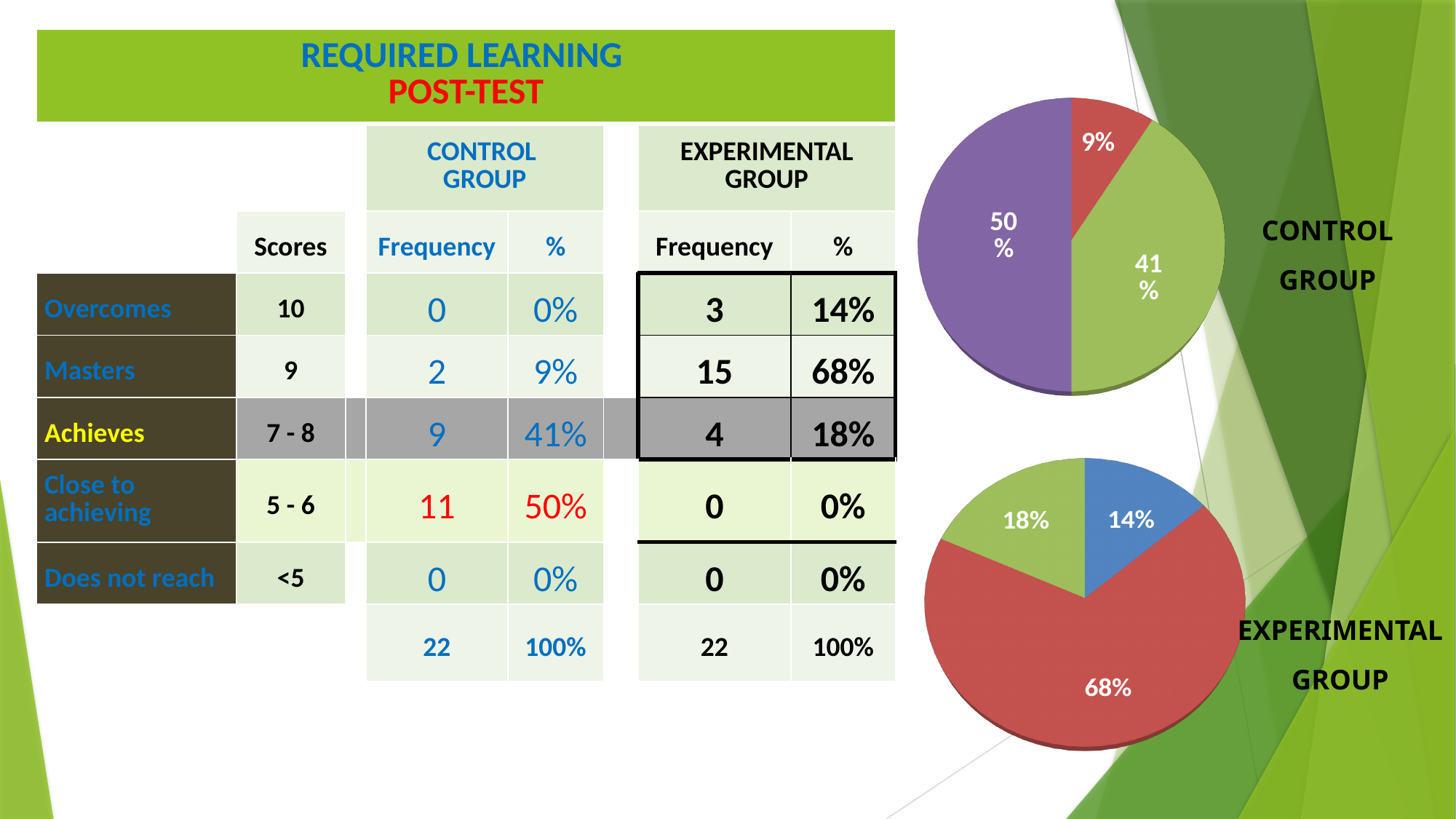
In the Control Group pie chart, what is the difference between the 50% slice and the 41% slice? 9% In the Experimental Group pie chart, what is the difference between the largest and smallest slices? 54% In the Experimental Group pie chart, what colour is the 68% slice? Red In the Control Group pie chart, what is the largest slice's percentage? 50% In the Control Group pie chart, what is the smallest slice's percentage? 9% In the Control Group pie chart, what colour is the 50% slice? Purple In the Experimental Group pie chart, what is the smallest slice's percentage? 14% In the Experimental Group pie chart, what is the largest slice's percentage? 68% How many slices does the Control Group pie chart have? 3 What type of chart is used for the Control Group on the right of the slide? Pie chart How many slices does the Experimental Group pie chart have? 3 Which is larger: the largest slice of the Control Group pie chart or the largest slice of the Experimental Group pie chart? Experimental Group (68%)